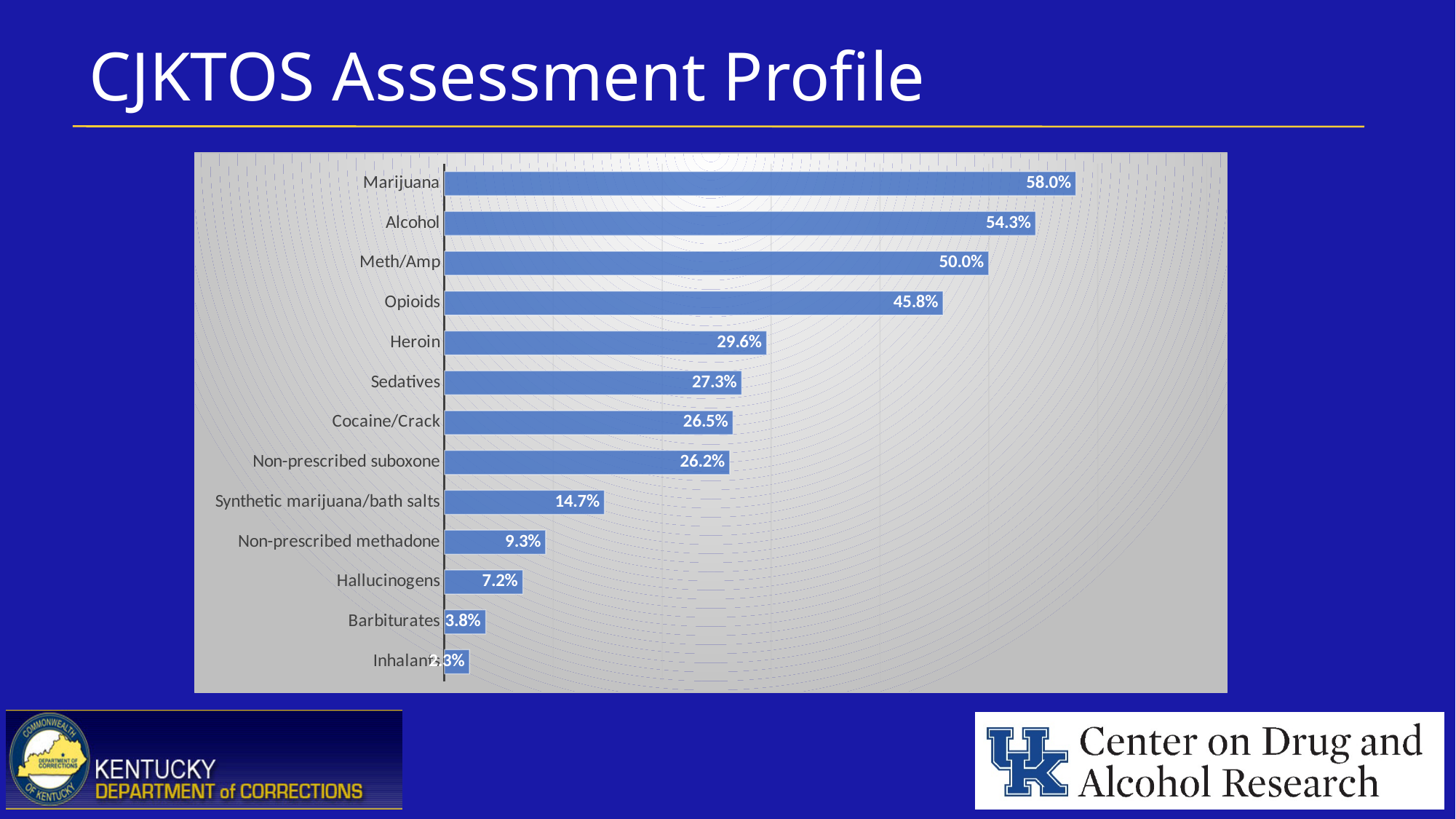
What is the value for Synthetic marijuana/bath salts? 14.7% Which category has the lowest value? Inhalants What is the value for Non-prescribed suboxone? 26.2% What kind of chart is shown on the slide? Bar chart What is the difference between the values for Marijuana and Alcohol? 3.7% What is the value for Opioids? 45.8% Which is larger, the value for Meth/Amp or the value for Opioids? Meth/Amp Which category has the highest value? Marijuana What is the value for Hallucinogens? 7.2% What is the value for Marijuana? 58.0% How many categories are shown in the chart? 13 What is the difference between the values for Heroin and Sedatives? 2.3%